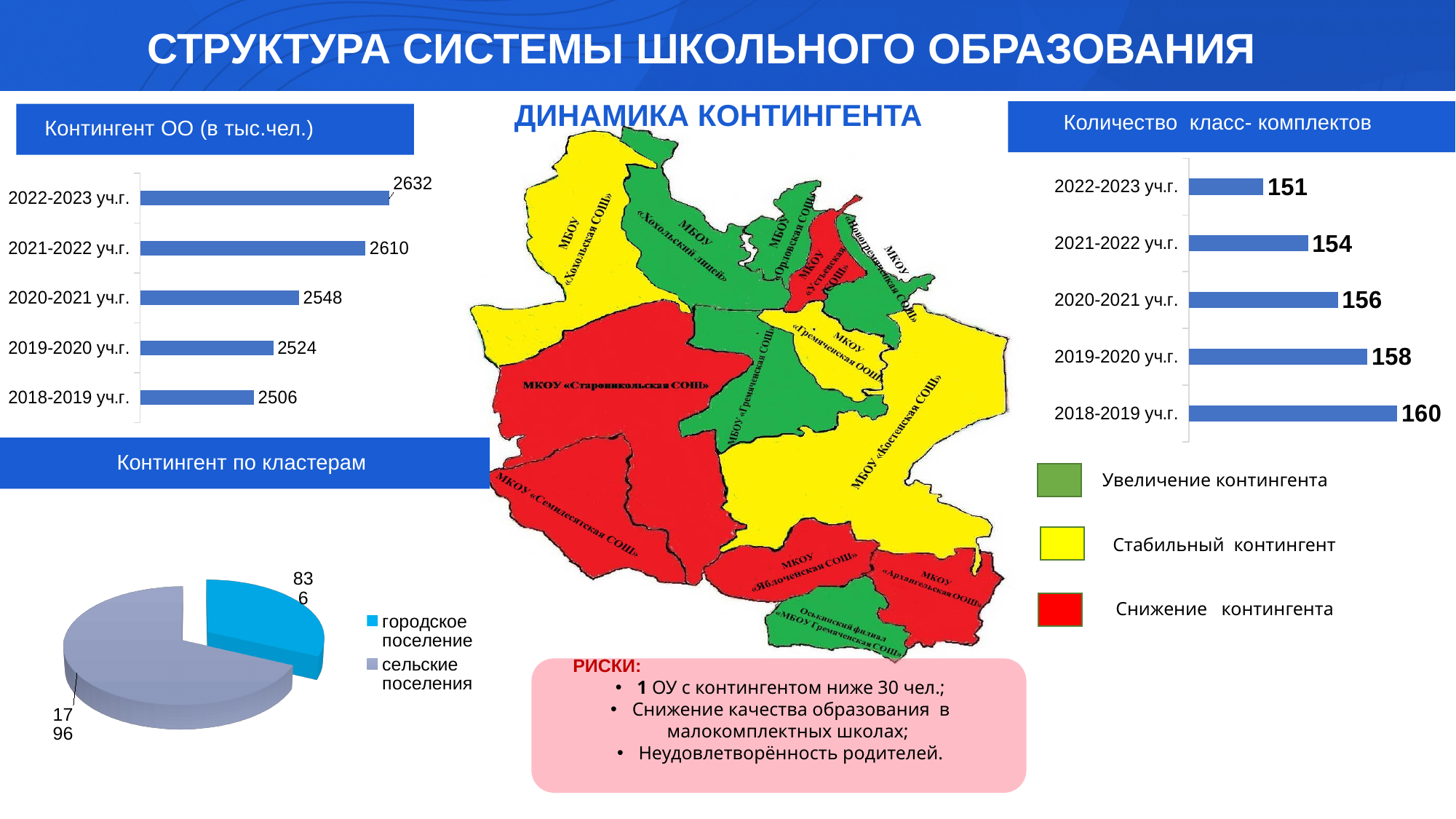
In the chart 'Контингент ОО (в тыс.чел.)', what is the value for 2022-2023 уч.г.? 2632 In the chart 'Количество класс-комплектов', which is larger: the value for 2019-2020 уч.г. or 2021-2022 уч.г.? 2019-2020 уч.г. In the chart 'Контингент по кластерам', how many entries does the legend list? 2 In the chart 'Контингент ОО (в тыс.чел.)', how many school years are shown? 5 In the chart 'Контингент ОО (в тыс.чел.)', what is the difference between the values for 2022-2023 уч.г. and 2021-2022 уч.г.? 22 In the chart 'Количество класс-комплектов', what is the value for 2020-2021 уч.г.? 156 In the chart 'Количество класс-комплектов', what is the difference between the values for 2018-2019 уч.г. and 2022-2023 уч.г.? 9 In the chart 'Контингент ОО (в тыс.чел.)', what is the value for 2018-2019 уч.г.? 2506 In the chart 'Контингент по кластерам', which slice is larger: 'городское поселение' or 'сельские поселения'? сельские поселения In the chart 'Количество класс-комплектов', which school year has the highest value? 2018-2019 уч.г. In the chart 'Контингент ОО (в тыс.чел.)', which school year has the lowest value? 2018-2019 уч.г. What kind of chart is 'Контингент по кластерам'? Pie chart